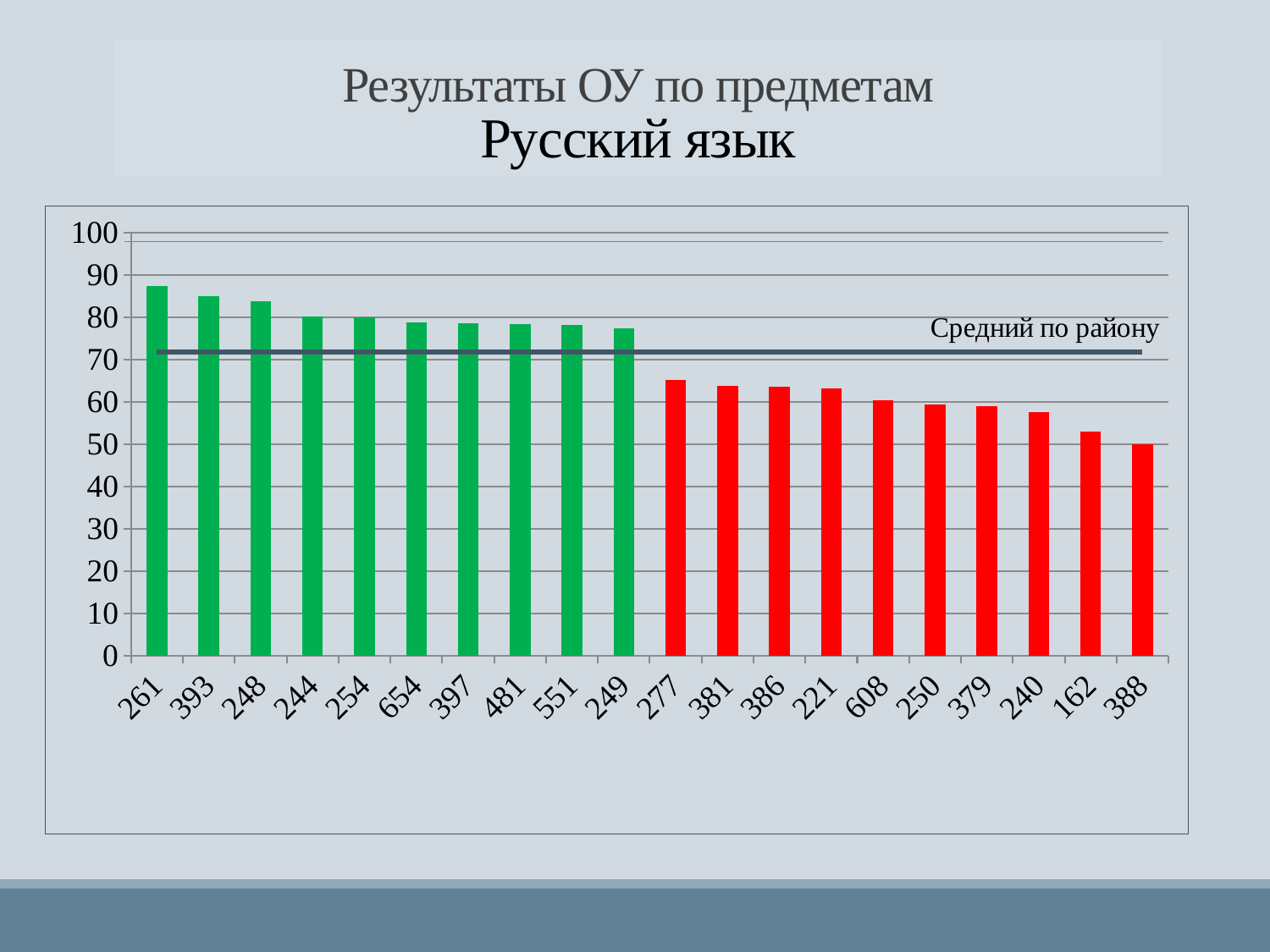
Which category has the highest value? 261 Which category has the lowest value? 388 Is the value for 261 greater or less than 80? greater Is the value for 277 greater or less than 70? less How many categories (bars) are shown on the x axis? 20 Is the value for 244 greater or less than 70? greater What colour are the bars that lie below the horizontal line? red Which has the larger value, 393 or 381? 393 What is the label of the horizontal line drawn across the chart? Средний по району What kind of chart is shown on the slide? bar chart Do the values rise or fall from left to right along the x axis? fall